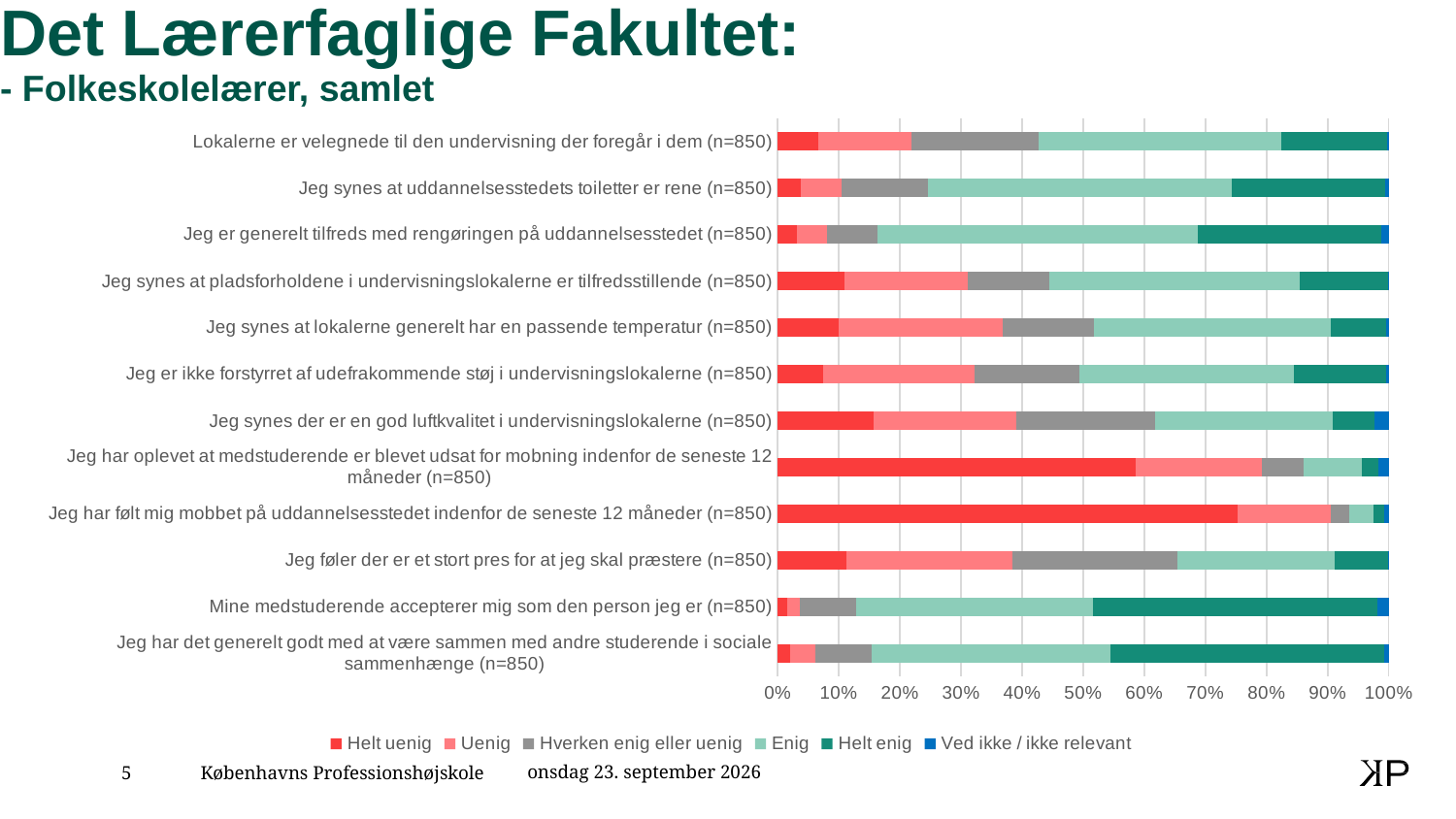
What is the sample size (n) shown for each statement in the chart? 850 Which has the larger 'Helt enig' share: 'Mine medstuderende accepterer mig som den person jeg er' or 'Jeg synes at lokalerne generelt har en passende temperatur'? Mine medstuderende accepterer mig som den person jeg er How many series does the legend list? 6 Which has the larger 'Helt uenig' share: 'Jeg har følt mig mobbet på uddannelsesstedet indenfor de seneste 12 måneder' or 'Jeg synes at uddannelsesstedets toiletter er rene'? Jeg har følt mig mobbet på uddannelsesstedet indenfor de seneste 12 måneder Is the 'Helt uenig' share for 'Jeg har følt mig mobbet på uddannelsesstedet indenfor de seneste 12 måneder' greater or less than 70%? greater Which statement has the largest 'Helt uenig' share? Jeg har følt mig mobbet på uddannelsesstedet indenfor de seneste 12 måneder (n=850) Is the 'Helt uenig' share for 'Jeg synes at uddannelsesstedets toiletter er rene' greater or less than 10%? less Is the 'Helt uenig' share for 'Jeg har oplevet at medstuderende er blevet udsat for mobning indenfor de seneste 12 måneder' greater or less than 50%? greater How many statements (categories) are plotted in the chart? 12 What is the last entry in the chart's legend? Ved ikke / ikke relevant What kind of chart is shown on the slide? Stacked bar chart